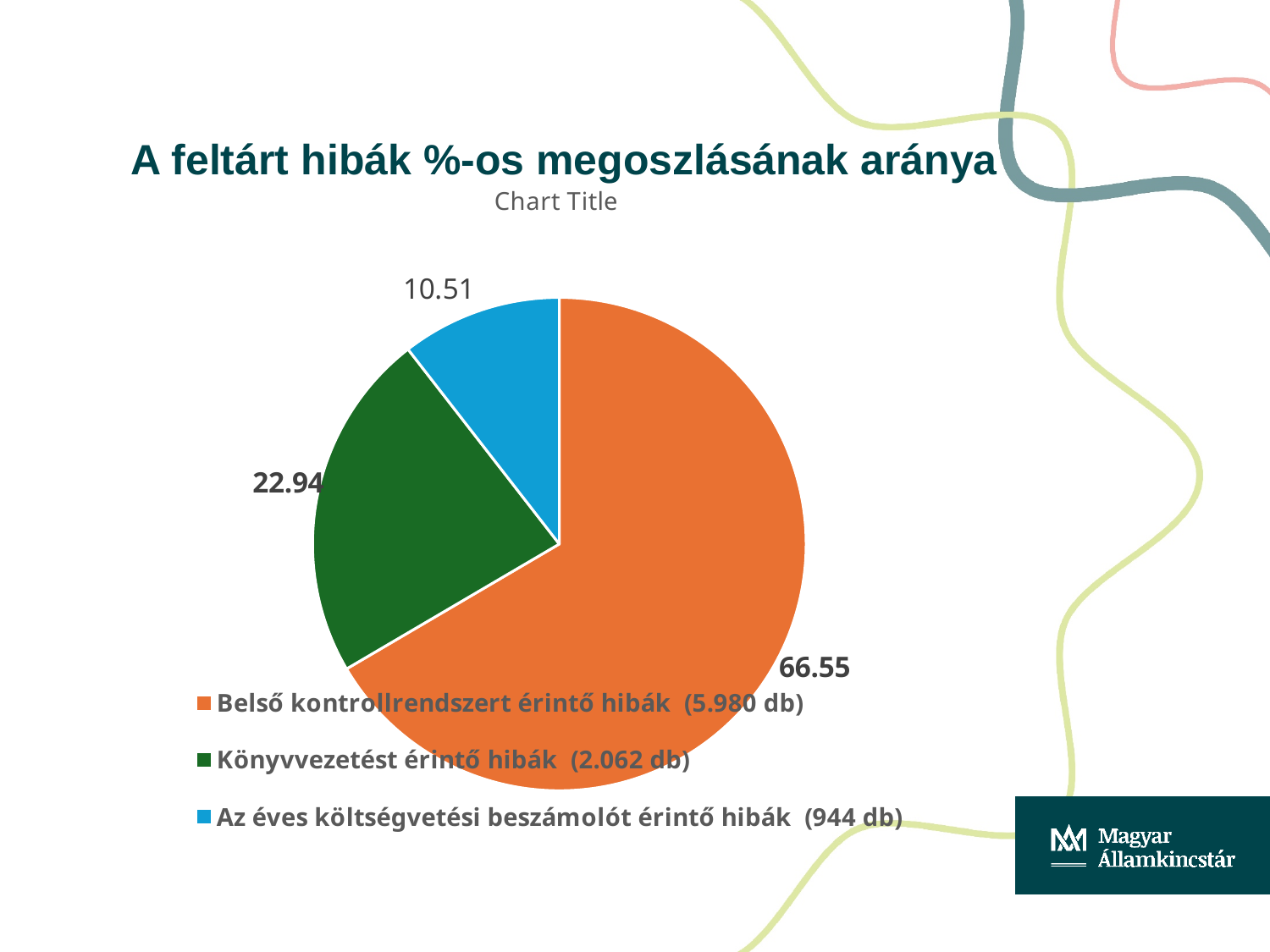
What colour is the slice for 'Könyvvezetést érintő hibák'? Green Which category has the largest slice of the pie? Belső kontrollrendszert érintő hibák Which category has the smallest slice of the pie? Az éves költségvetési beszámolót érintő hibák What is the difference between the values for 'Belső kontrollrendszert érintő hibák' and 'Könyvvezetést érintő hibák'? 43.61 What value is shown for the slice 'Belső kontrollrendszert érintő hibák'? 66.55 How many slices does the pie chart have? 3 What value is shown for the slice 'Könyvvezetést érintő hibák'? 22.94 What kind of chart is shown on the slide? Pie chart What value is shown for the slice 'Az éves költségvetési beszámolót érintő hibák'? 10.51 According to the legend, how many items (db) are in the 'Belső kontrollrendszert érintő hibák' category? 5.980 db How many entries does the legend list? 3 Which is larger: the slice for 'Könyvvezetést érintő hibák' or the slice for 'Az éves költségvetési beszámolót érintő hibák'? Könyvvezetést érintő hibák